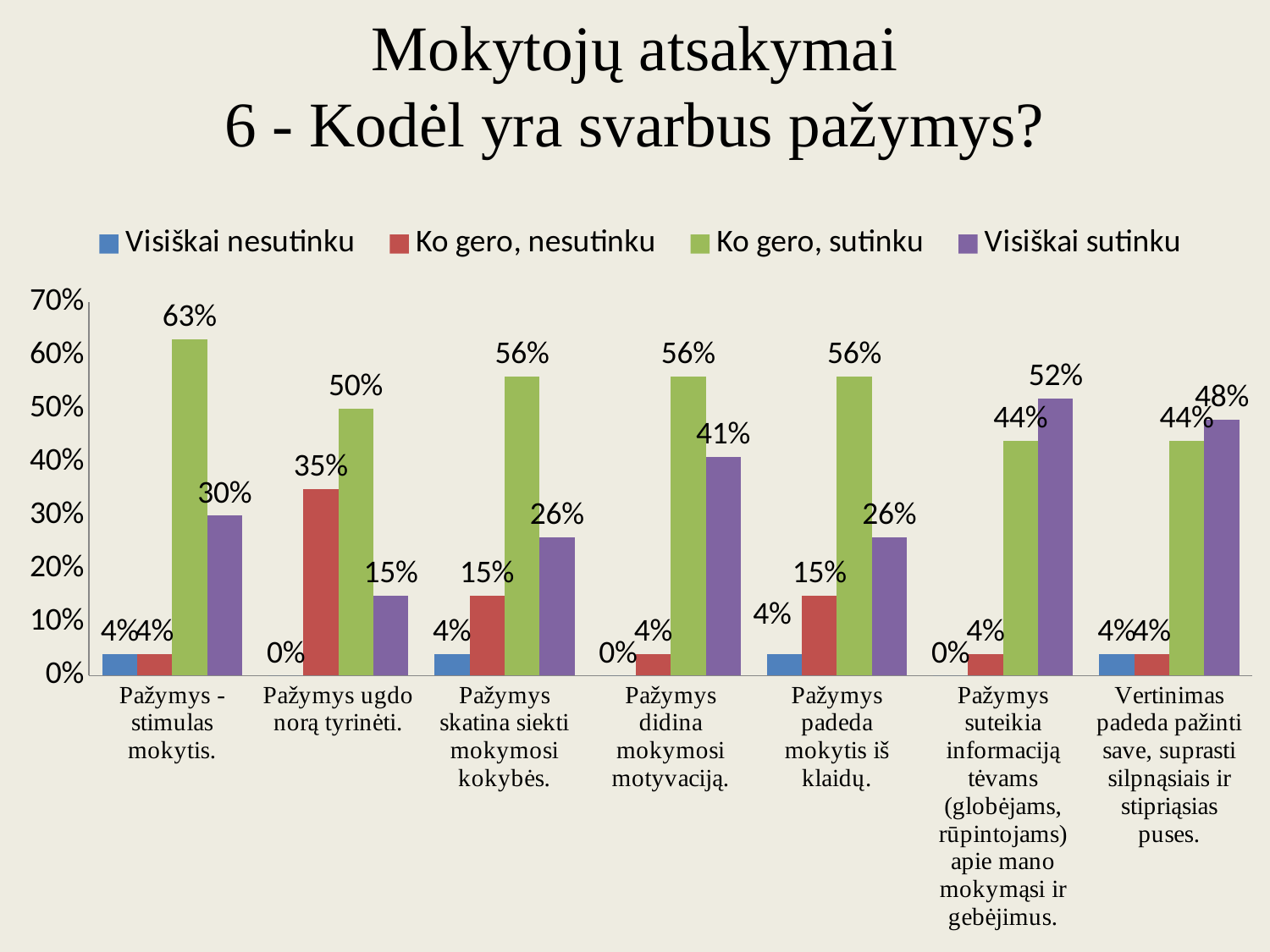
What is the value of "Visiškai sutinku" for "Pažymys didina mokymosi motyvaciją."? 41% Is the "Ko gero, sutinku" value for "Pažymys padeda mokytis iš klaidų." greater or less than 50%? greater What is the value of "Ko gero, nesutinku" for "Pažymys ugdo norą tyrinėti."? 35% How many series does the legend list? 4 What is the difference between "Ko gero, sutinku" and "Visiškai sutinku" for "Pažymys ugdo norą tyrinėti."? 35% For "Vertinimas padeda pažinti save, suprasti silpnąsias ir stipriąsias puses.", which is larger: "Ko gero, sutinku" or "Visiškai sutinku"? Visiškai sutinku What kind of chart is shown on the slide? bar chart What is the value of "Ko gero, sutinku" for "Pažymys - stimulas mokytis."? 63% Which category has the highest "Ko gero, sutinku" value? Pažymys - stimulas mokytis. Which category has the highest "Visiškai sutinku" value? Pažymys suteikia informaciją tėvams (globėjams, rūpintojams) apie mano mokymąsi ir gebėjimus. What is the title of the slide? Mokytojų atsakymai 6 - Kodėl yra svarbus pažymys? How many categories are shown on the x axis? 7